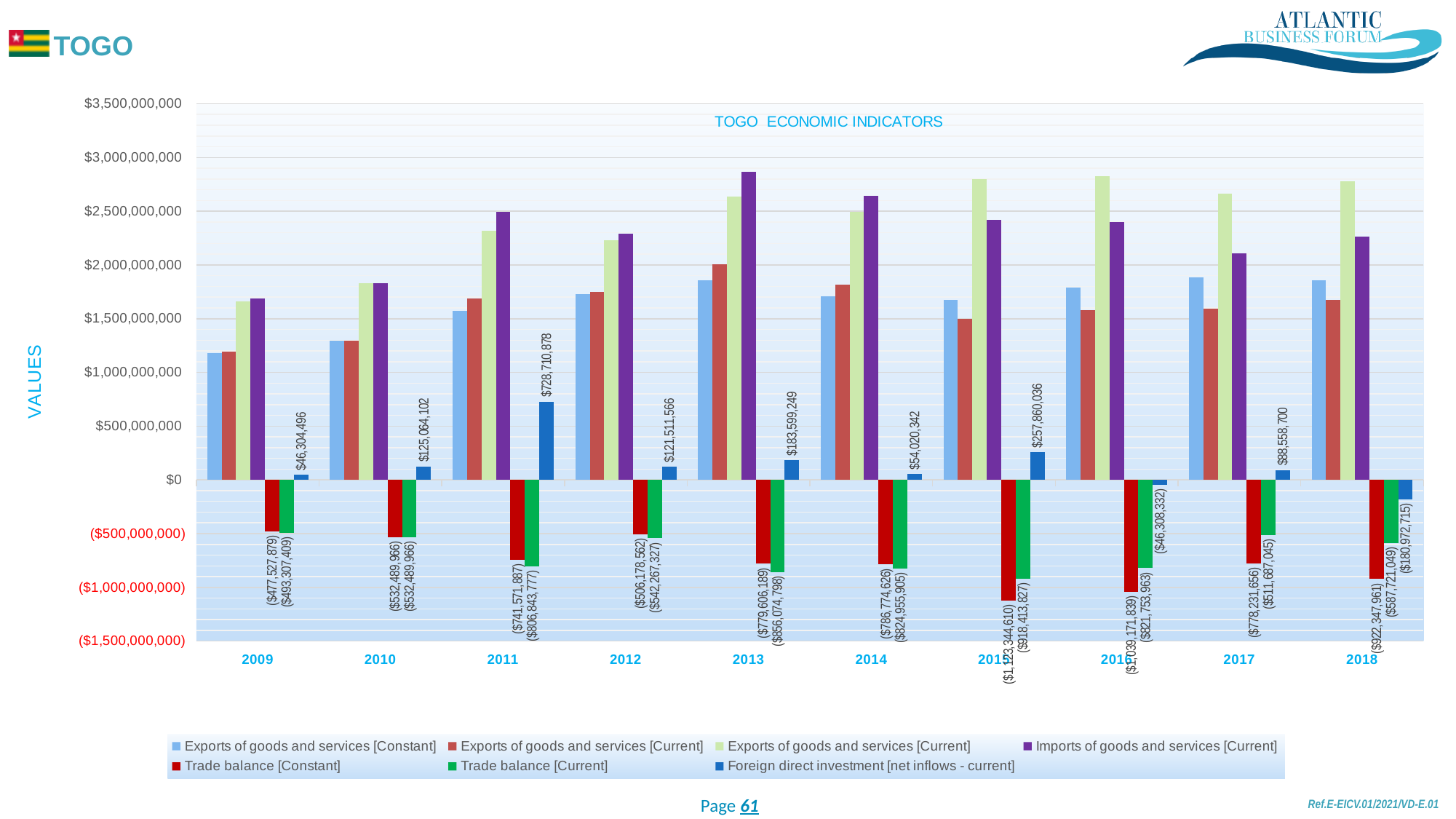
Which year has the larger Foreign direct investment [net inflows - current], 2013 or 2015? 2015 What is the difference between Foreign direct investment [net inflows - current] in 2011 and in 2010? $603,646,776 What is the value of Trade balance [Constant] in 2015? ($1,123,344,610) In which year is Foreign direct investment [net inflows - current] highest? 2011 What is the value of Foreign direct investment [net inflows - current] in 2011? $728,710,878 How many series does the legend list? 7 In which year is Foreign direct investment [net inflows - current] lowest? 2018 What is the title of the chart? TOGO ECONOMIC INDICATORS What type of chart is shown on the slide? Bar chart What is the value of Trade balance [Current] in 2017? ($511,687,045) Is the value for Imports of goods and services [Current] in 2013 greater or less than $2,500,000,000? greater How many years are shown on the x axis? 10